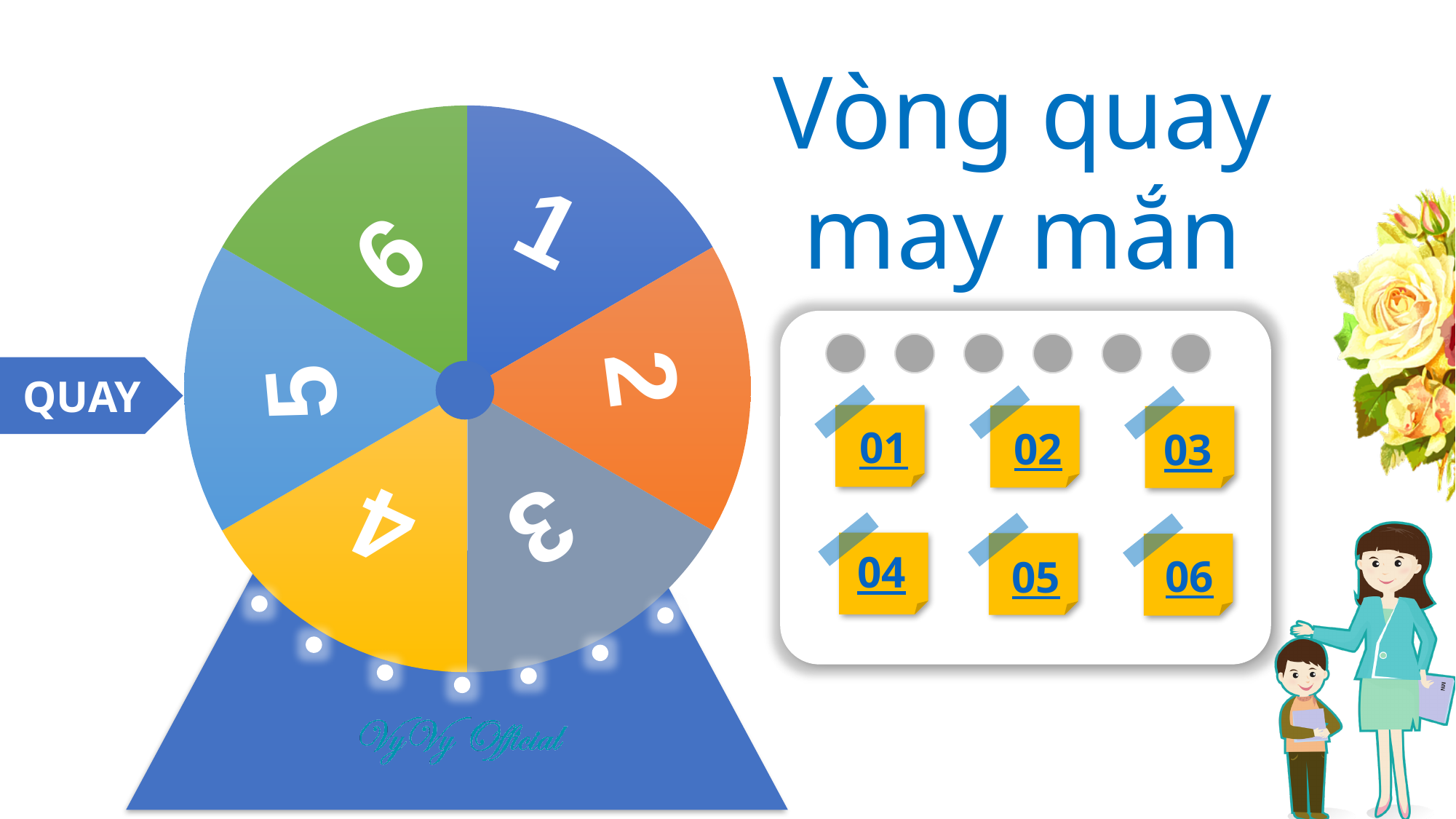
What kind of chart is the wheel on the left of the slide? pie chart Which number is printed on the green segment of the wheel? 6 Which number is printed on the yellow segment of the wheel? 4 Which number is printed on the grey segment of the wheel? 3 How many segments does the wheel on the left have? 6 What colour is the segment labelled 2 on the wheel? orange What is the title shown to the right of the wheel? Vòng quay may mắn Is the segment labelled 1 larger or the same size as the segment labelled 5 on the wheel? the same size